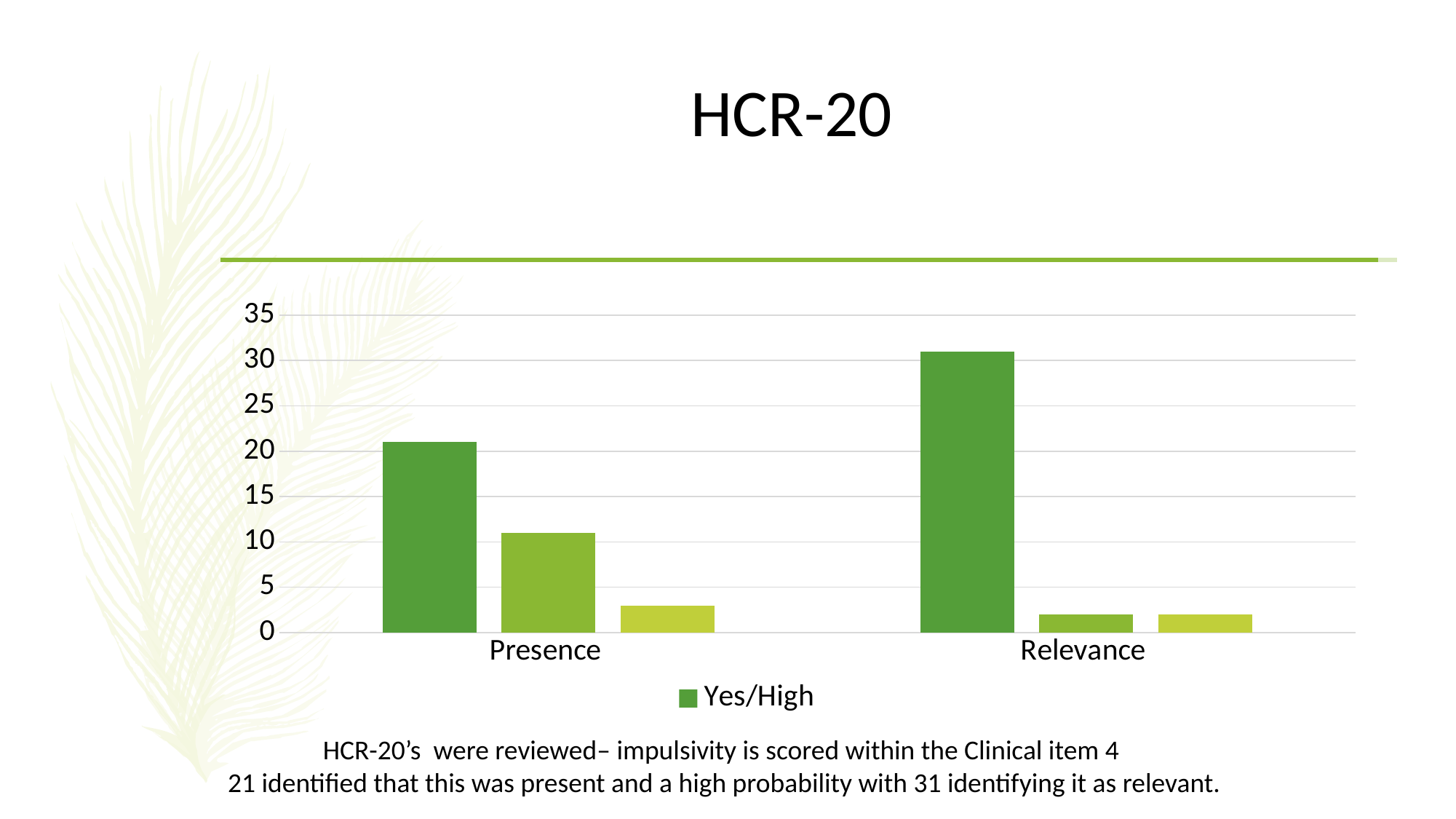
Is the value of the rightmost bar for Presence greater or less than 5? less Is the value of the middle bar for Presence greater or less than 15? less Is the Yes/High value for Relevance greater or less than 30? greater Which category has the tallest bar? Relevance What is the title of the chart? HCR-20 What series name is shown in the legend? Yes/High Which is larger, the Yes/High bar for Presence or the Yes/High bar for Relevance? Relevance How many series does the legend list? 1 What kind of chart is shown on the slide? bar chart How many categories are shown on the x axis? 2